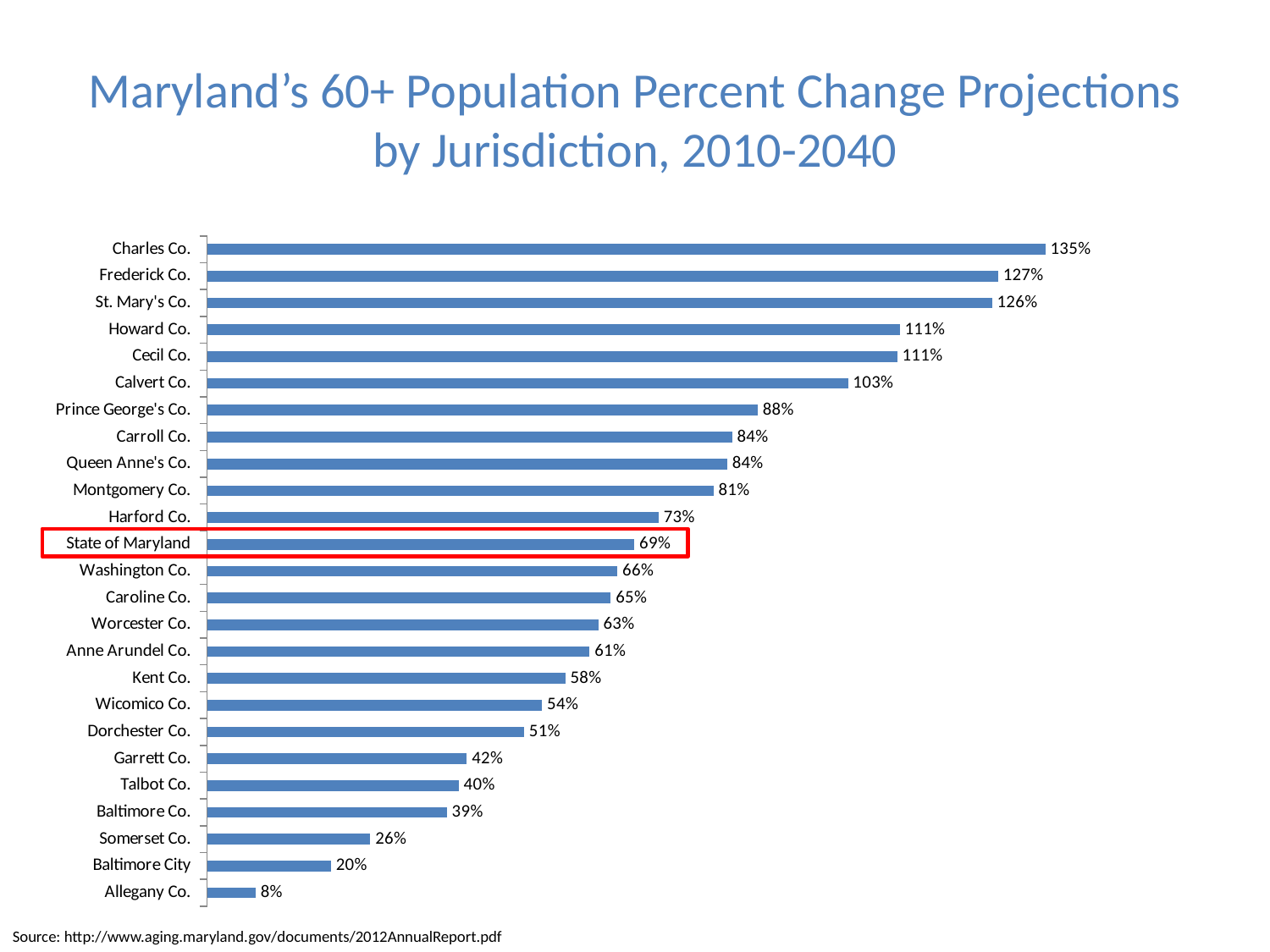
Which jurisdiction's bar is highlighted with a red box? State of Maryland What is the difference between the projected percent change for Frederick Co. and Montgomery Co.? 46% Which jurisdiction has the lowest projected percent change? Allegany Co. Which jurisdiction has the highest projected percent change? Charles Co. Which has a larger projected percent change, Harford Co. or Kent Co.? Harford Co. What is the difference between the projected percent change for Calvert Co. and Somerset Co.? 77% What is the title of the chart? Maryland's 60+ Population Percent Change Projections by Jurisdiction, 2010-2040 How many jurisdictions (bars) are shown on the chart? 25 What kind of chart is shown on the slide? Bar chart What is the projected percent change for Charles Co.? 135% What is the projected percent change for Baltimore City? 20% What is the projected percent change for the State of Maryland? 69%